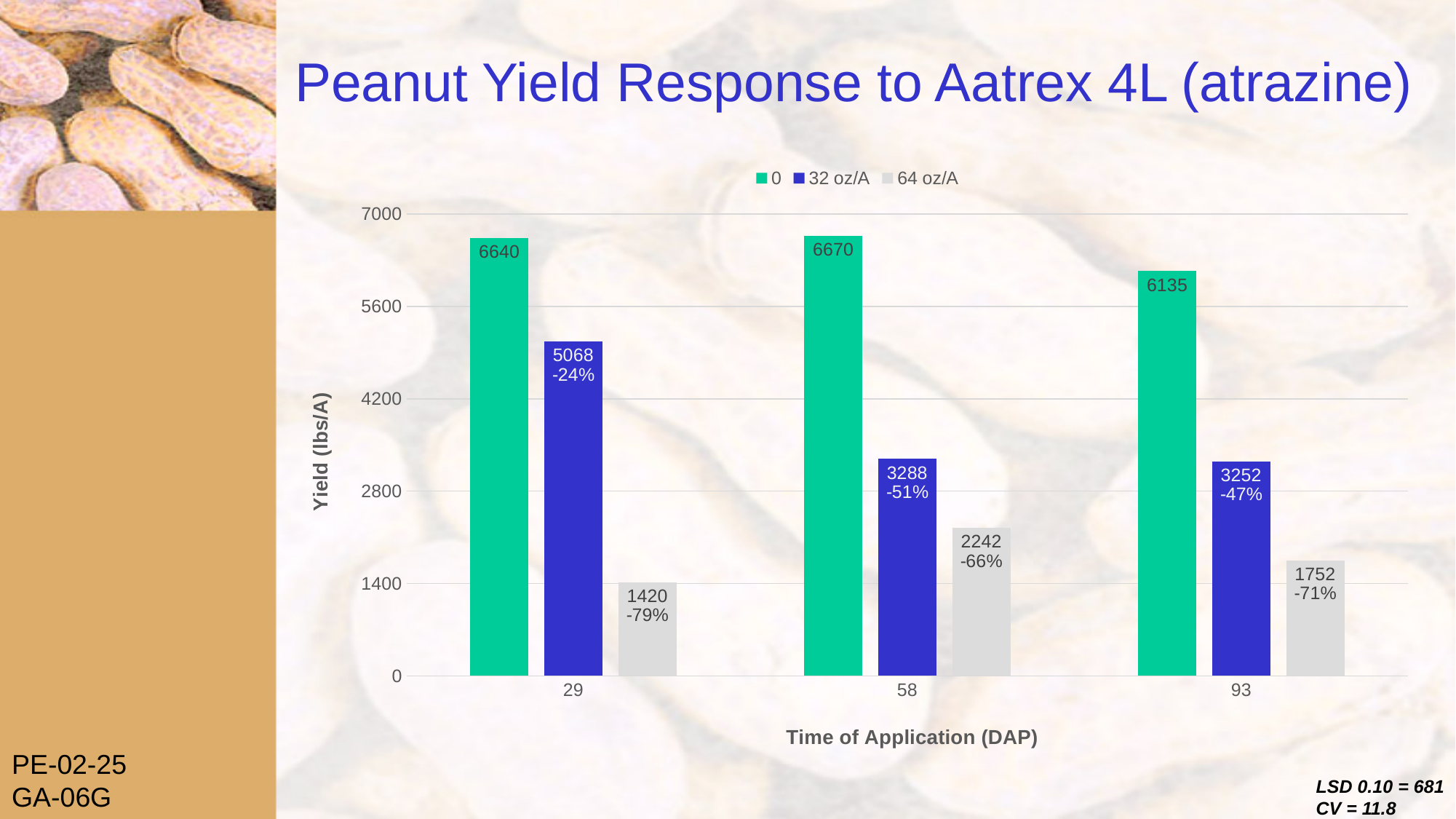
What is the label of the y axis? Yield (lbs/A) What is the yield for the 64 oz/A series at 58 DAP? 2242 What is the yield for the 0 series at 29 DAP? 6640 What is the difference between the 0 and 32 oz/A yields at 29 DAP? 1572 Which time of application has the highest yield for the 0 series? 58 How many times of application are shown on the x axis? 3 Which time of application has the lowest yield for the 64 oz/A series? 29 How many series does the legend list? 3 What is the yield for the 32 oz/A series at 93 DAP? 3252 What kind of chart is shown on the slide? bar chart Is the 64 oz/A yield at 93 DAP greater or less than 2800? less Which is larger, the 32 oz/A yield at 58 DAP or the 32 oz/A yield at 93 DAP? 58 DAP